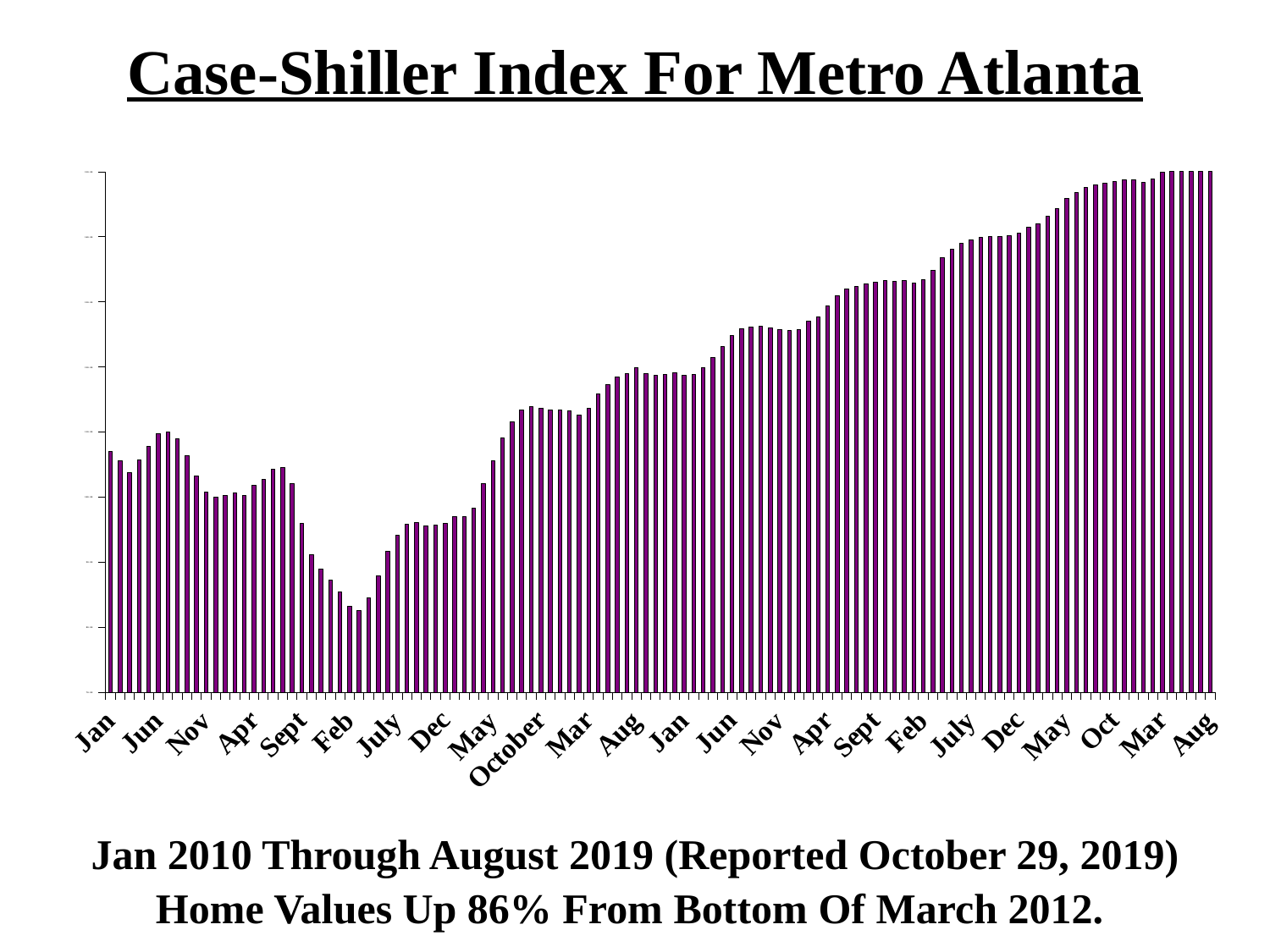
What is the title of the chart? Case-Shiller Index For Metro Atlanta What period does the chart cover, according to the text below it? Jan 2010 Through August 2019 Is the value at the bar labelled Feb (2012) larger or smaller than the value at the first bar labelled Jan (2010)? smaller Overall, do the values rise or fall from the left of the x axis to the right? rise What kind of chart is shown on the slide? bar chart Which x-axis label corresponds to the highest bar in the chart? Aug Is the value for the bar labelled Jun (2010) larger or smaller than the value for the bar labelled Feb (2012)? larger Between the first bar (Jan 2010) and the bar labelled Feb (2012), do the values generally rise or fall? fall According to the slide, in which month and year did the index reach its bottom? March 2012 By what percentage does the slide say home values are up from the bottom of March 2012? 86% What colour are the bars in the chart? purple Is the value for the last bar (Aug 2019) larger or smaller than the value for the first bar (Jan 2010)? larger